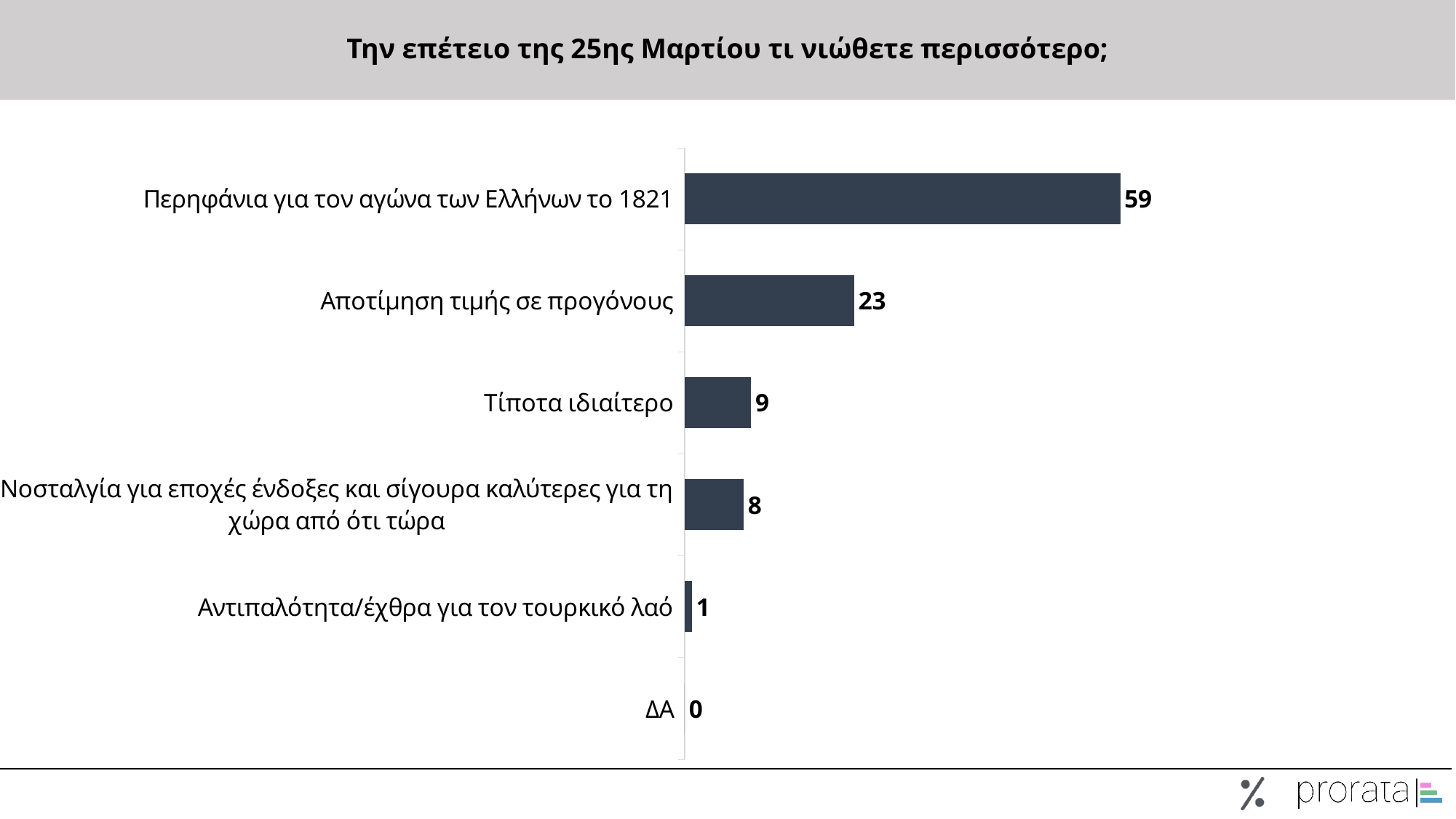
What is the title of the chart? Την επέτειο της 25ης Μαρτίου τι νιώθετε περισσότερο; How many categories are shown in the chart? 6 What is the value for 'Αποτίμηση τιμής σε προγόνους'? 23 What kind of chart is shown on the slide? Bar chart What is the value for 'ΔΑ'? 0 What is the difference between the values for 'Περηφάνια για τον αγώνα των Ελλήνων το 1821' and 'Αποτίμηση τιμής σε προγόνους'? 36 What is the value for 'Τίποτα ιδιαίτερο'? 9 What is the value for 'Αντιπαλότητα/έχθρα για τον τουρκικό λαό'? 1 Which category has the highest value? Περηφάνια για τον αγώνα των Ελλήνων το 1821 What is the value for 'Περηφάνια για τον αγώνα των Ελλήνων το 1821'? 59 Which category has the lowest value? ΔΑ Which is larger: the value for 'Τίποτα ιδιαίτερο' or the value for 'Νοσταλγία για εποχές ένδοξες και σίγουρα καλύτερες για τη χώρα από ότι τώρα'? Τίποτα ιδιαίτερο